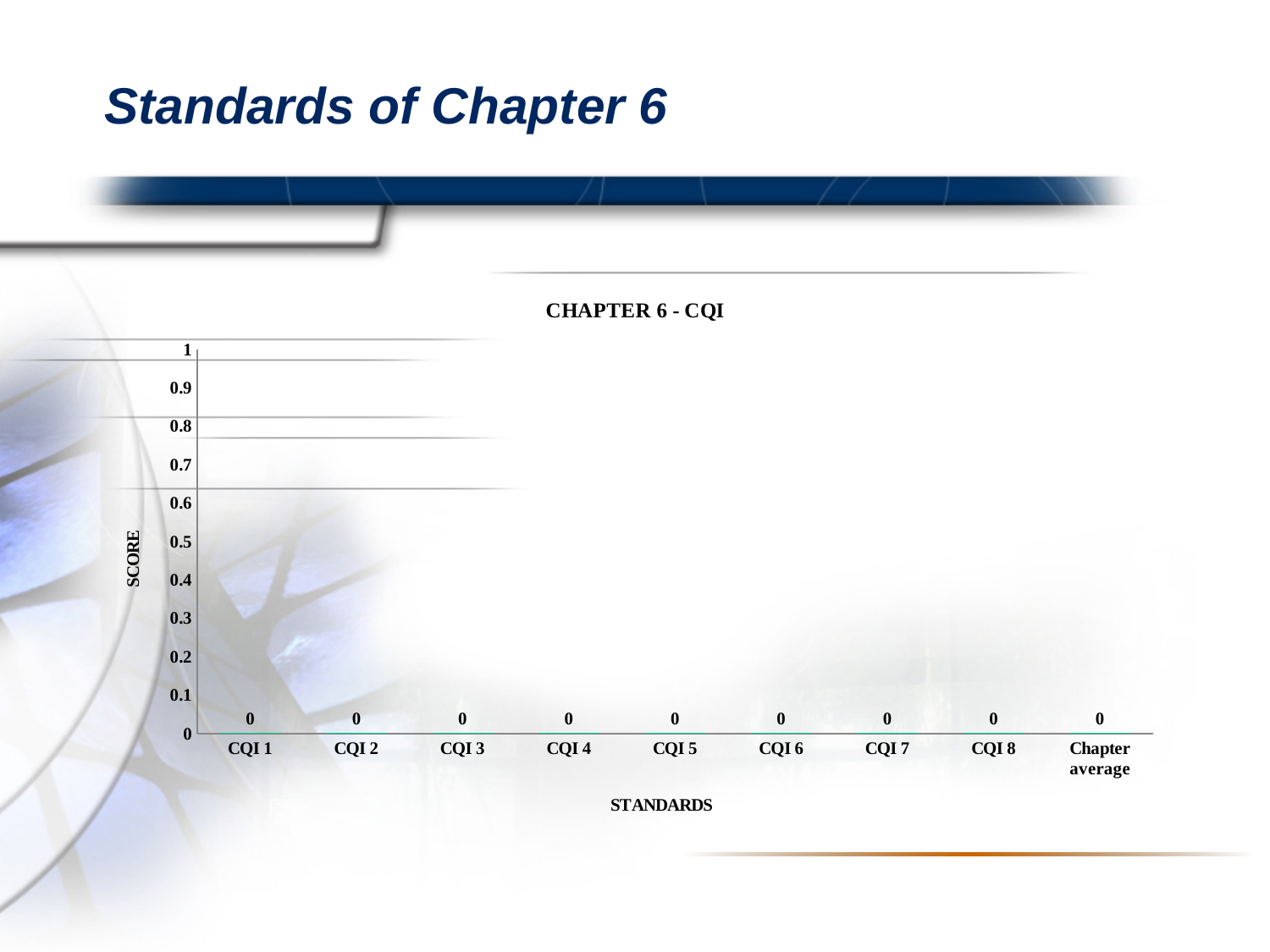
What is the value for Chapter average? 0 Is the value for CQI 4 greater or less than 0.5? less What is the value for CQI 1? 0 What kind of chart is this? bar chart How many categories are shown on the x axis? 9 What is the value for CQI 8? 0 Do the values rise, fall, or stay flat from CQI 1 to CQI 8? stay flat What is the title of the chart? CHAPTER 6 - CQI What is the label on the vertical axis? SCORE What is the difference between the values for CQI 3 and CQI 7? 0 What is the value for CQI 5? 0